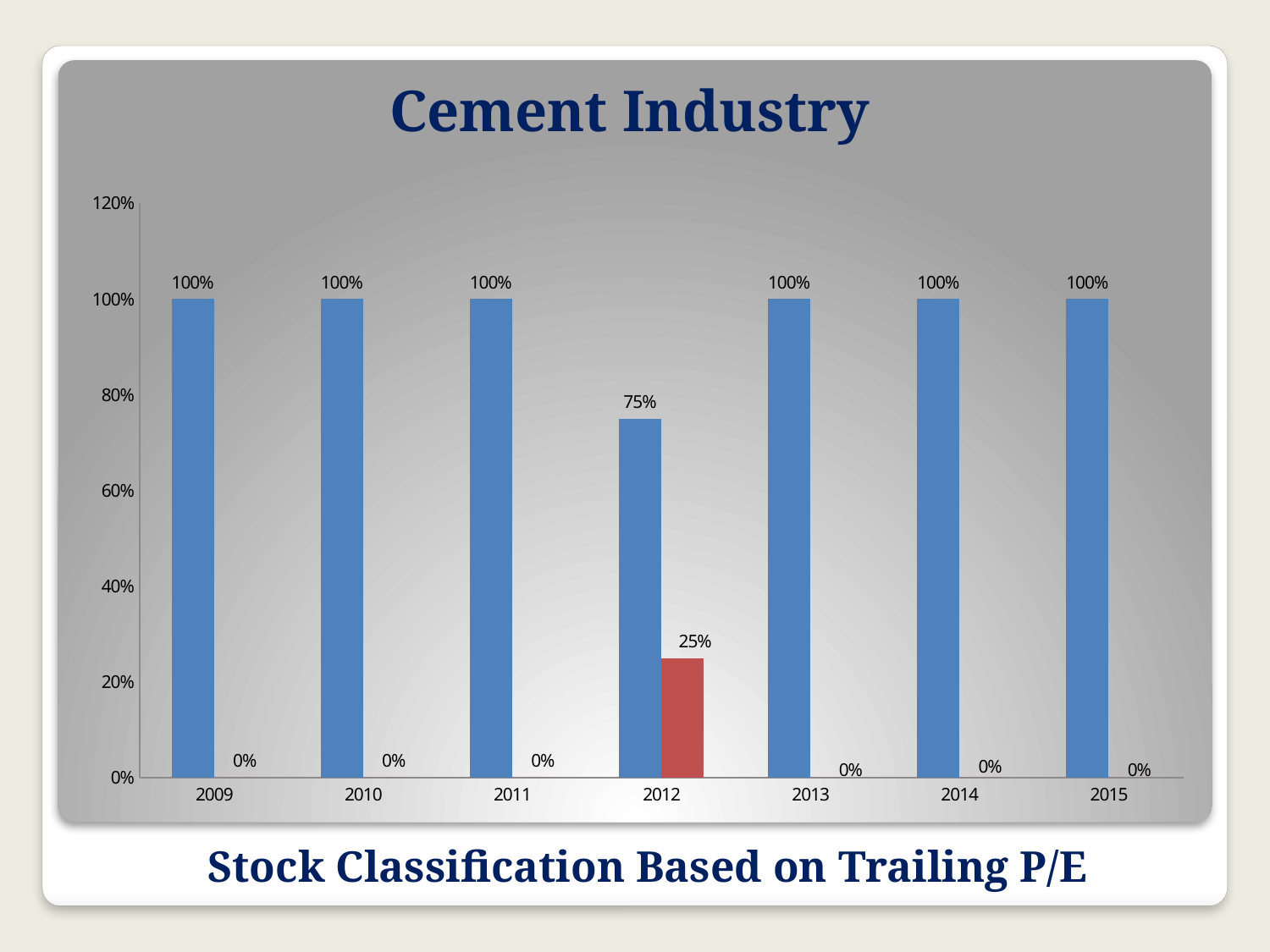
Which year has the lowest value for the blue bars? 2012 What is the value of the blue bar for 2012? 75% What is the difference between the blue bar and the red bar in 2012? 50% What is the title of the chart? Cement Industry What is the value of the blue bar for 2009? 100% What is the value of the red bar for 2014? 0% In 2012, which is larger, the blue bar or the red bar? the blue bar Which year has the highest value for the red bars? 2012 What kind of chart is shown on the slide? bar chart What is the value of the red bar for 2012? 25% How many years are shown on the x axis? 7 What is the total of the blue and red bars for 2012? 100%